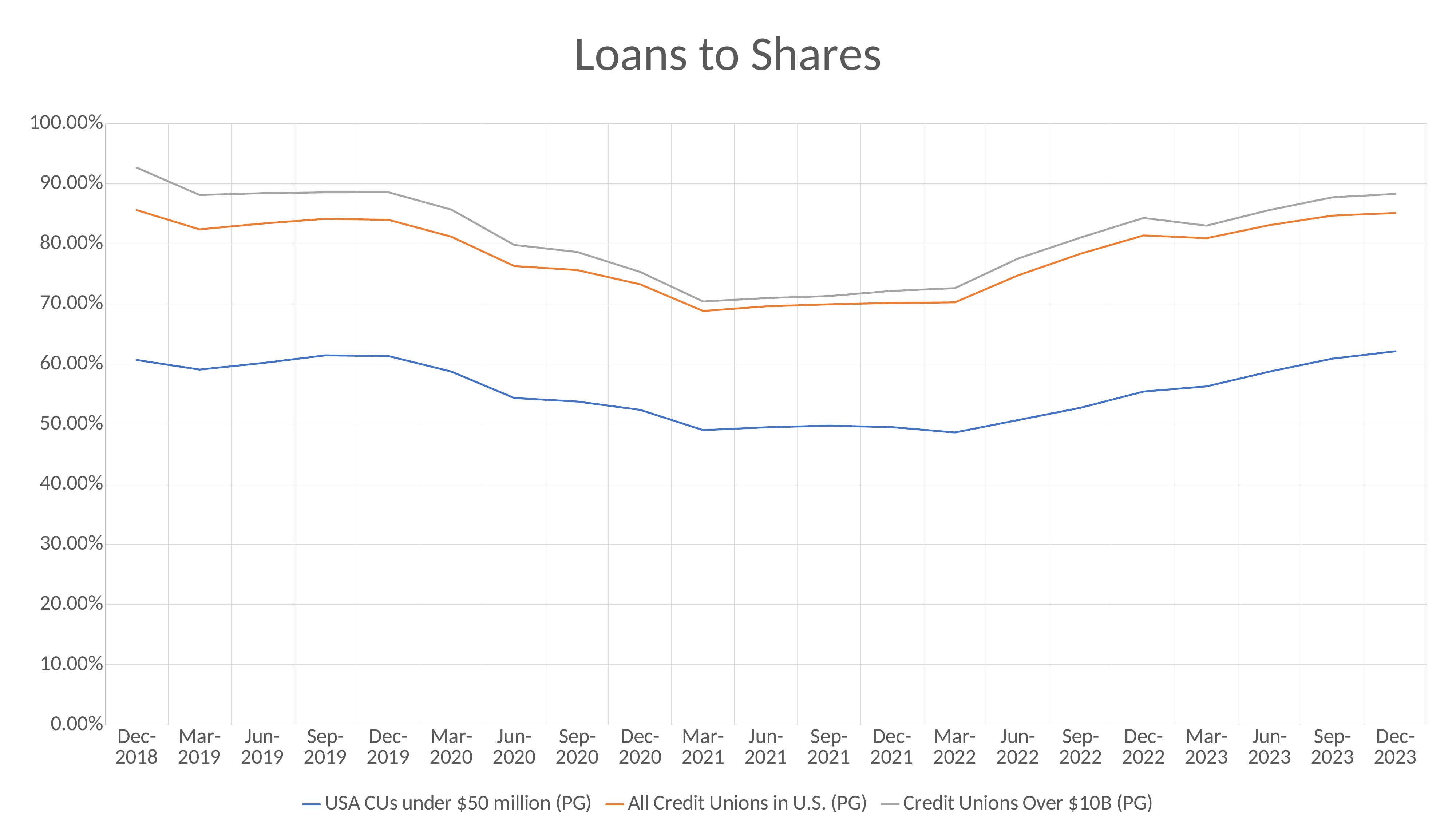
Is the value for All Credit Unions in U.S. (PG) at Jun-2020 greater or less than 70.00%? greater Which series is drawn in orange? All Credit Unions in U.S. (PG) What is the title of the chart? Loans to Shares At which point on the x axis does Credit Unions Over $10B (PG) reach its highest value? Dec-2018 Does the value for USA CUs under $50 million (PG) rise or fall from Dec-2019 to Mar-2021? fall Is the value for Credit Unions Over $10B (PG) at Dec-2018 greater or less than 90.00%? greater What kind of chart is shown on the slide? line chart Is the value for Credit Unions Over $10B (PG) at Dec-2023 greater or less than 80.00%? greater How many points are shown along the x axis? 21 How many series does the legend list? 3 Which series has the highest value at Dec-2018? Credit Unions Over $10B (PG)